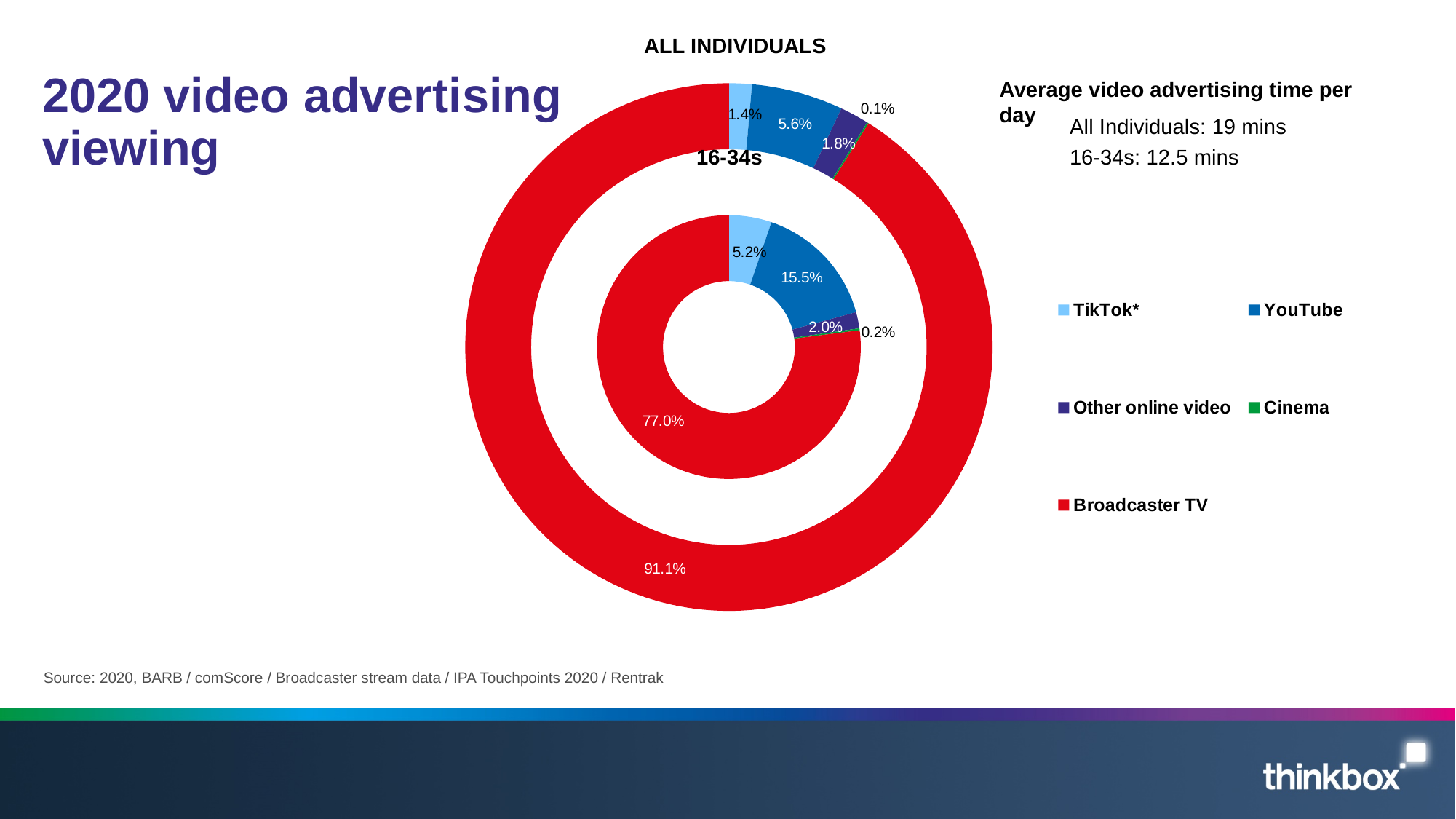
Which colour represents Broadcaster TV in the chart? Red How many categories does the legend list? 5 What kind of chart is shown on the slide? Doughnut chart What is the Other online video share for 16-34s? 2.0% What is the difference between the YouTube share for 16-34s and for All Individuals? 9.9% What is the difference between the Broadcaster TV share for All Individuals and for 16-34s? 14.1% Which category has the largest share in the 16-34s ring? Broadcaster TV Which is larger: the TikTok* share for 16-34s or the TikTok* share for All Individuals? 16-34s What share of video advertising viewing does YouTube account for among 16-34s? 15.5% What share of video advertising viewing does Broadcaster TV account for among All Individuals? 91.1% Which category has the smallest share in the All Individuals ring? Cinema What is the TikTok* share for All Individuals? 1.4%